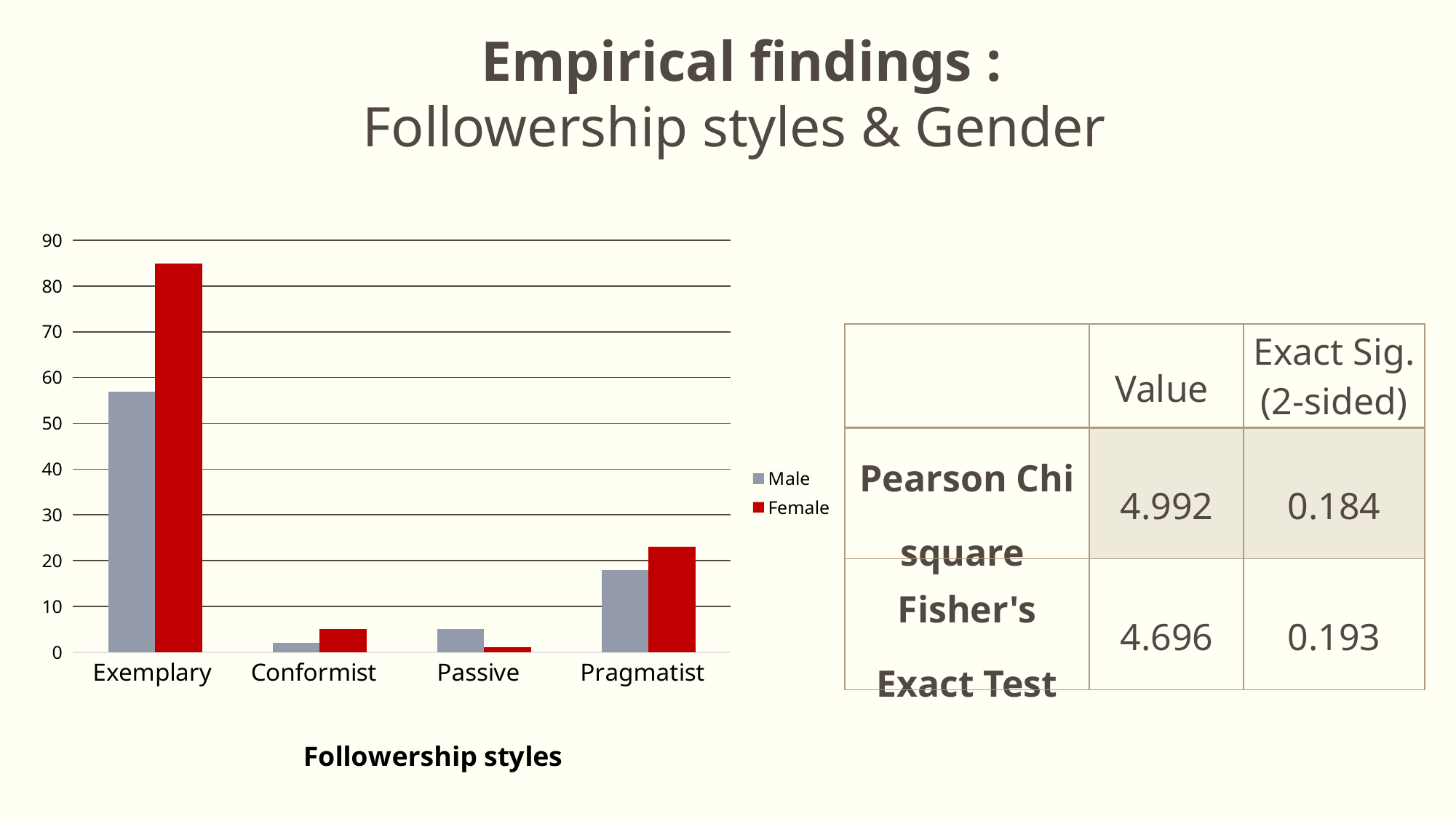
For Exemplary, which is larger, the Male value or the Female value? Female Which followership style has the highest Female value? Exemplary Is the Male value for Pragmatist greater or less than 20? less How many series does the chart's legend list? 2 What kind of chart is shown on the slide? bar chart Is the Female value for Exemplary greater or less than 80? greater What is the x axis title of the chart? Followership styles Which followership style has the highest Male value? Exemplary For Passive, which is larger, the Male value or the Female value? Male How many followership style categories are shown on the x axis of the chart? 4 Which followership style has the lowest Male value? Conformist Which followership style has the lowest Female value? Passive